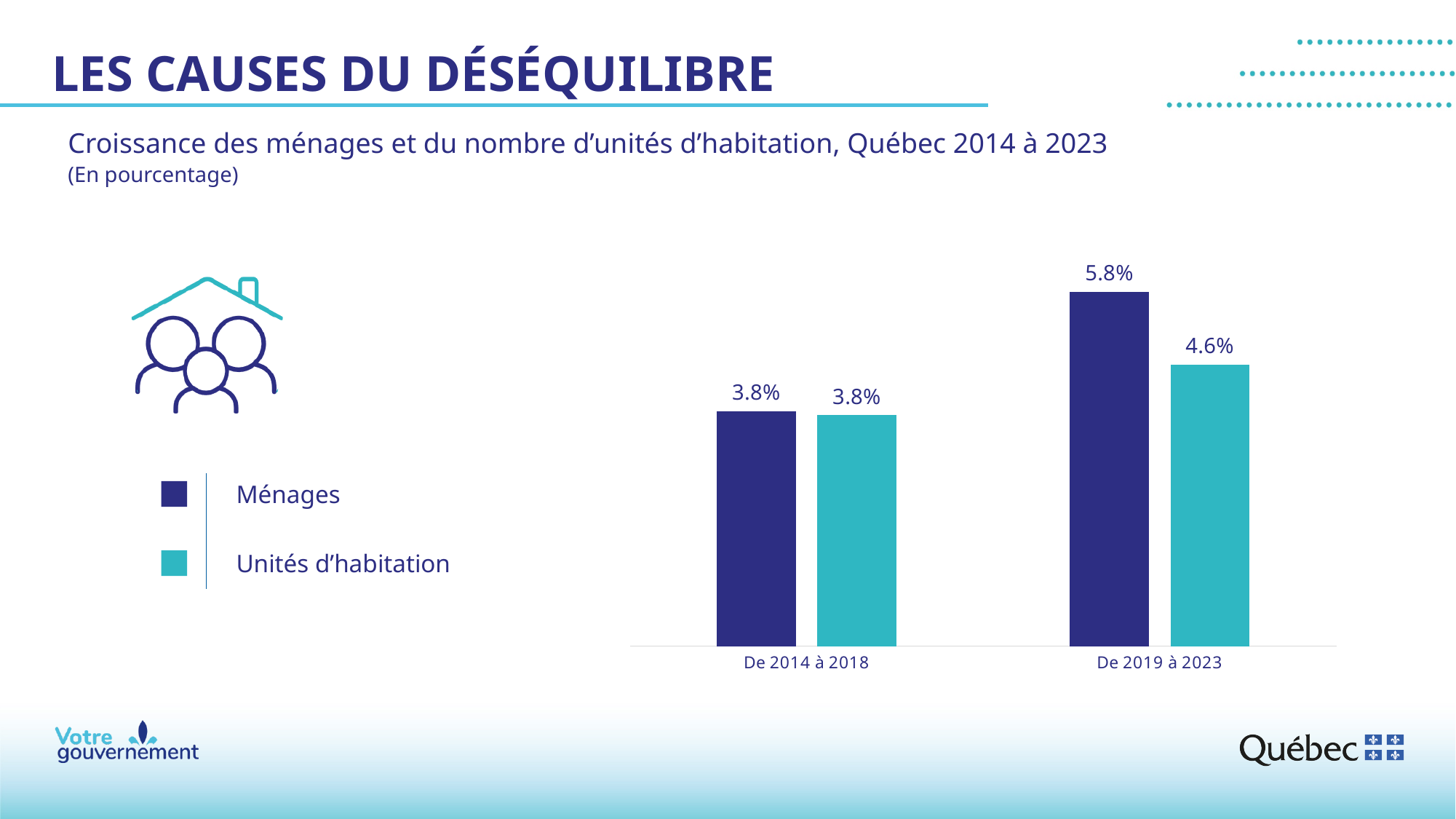
What kind of chart is shown on the slide? Bar chart How many periods are shown on the x axis? 2 In the period De 2019 à 2023, which is larger: Ménages or Unités d'habitation? Ménages How many series does the legend list? 2 Does the Ménages value rise or fall from De 2014 à 2018 to De 2019 à 2023? Rise What is the value for Ménages in the period De 2014 à 2018? 3.8% What is the value for Unités d'habitation in the period De 2019 à 2023? 4.6% Which bar has the highest value on the chart? Ménages, De 2019 à 2023 What is the difference between Ménages and Unités d'habitation in the period De 2019 à 2023? 1.2% What is the difference between the Ménages value for De 2019 à 2023 and the Ménages value for De 2014 à 2018? 2.0% What is the value for Ménages in the period De 2019 à 2023? 5.8% What is the value for Unités d'habitation in the period De 2014 à 2018? 3.8%